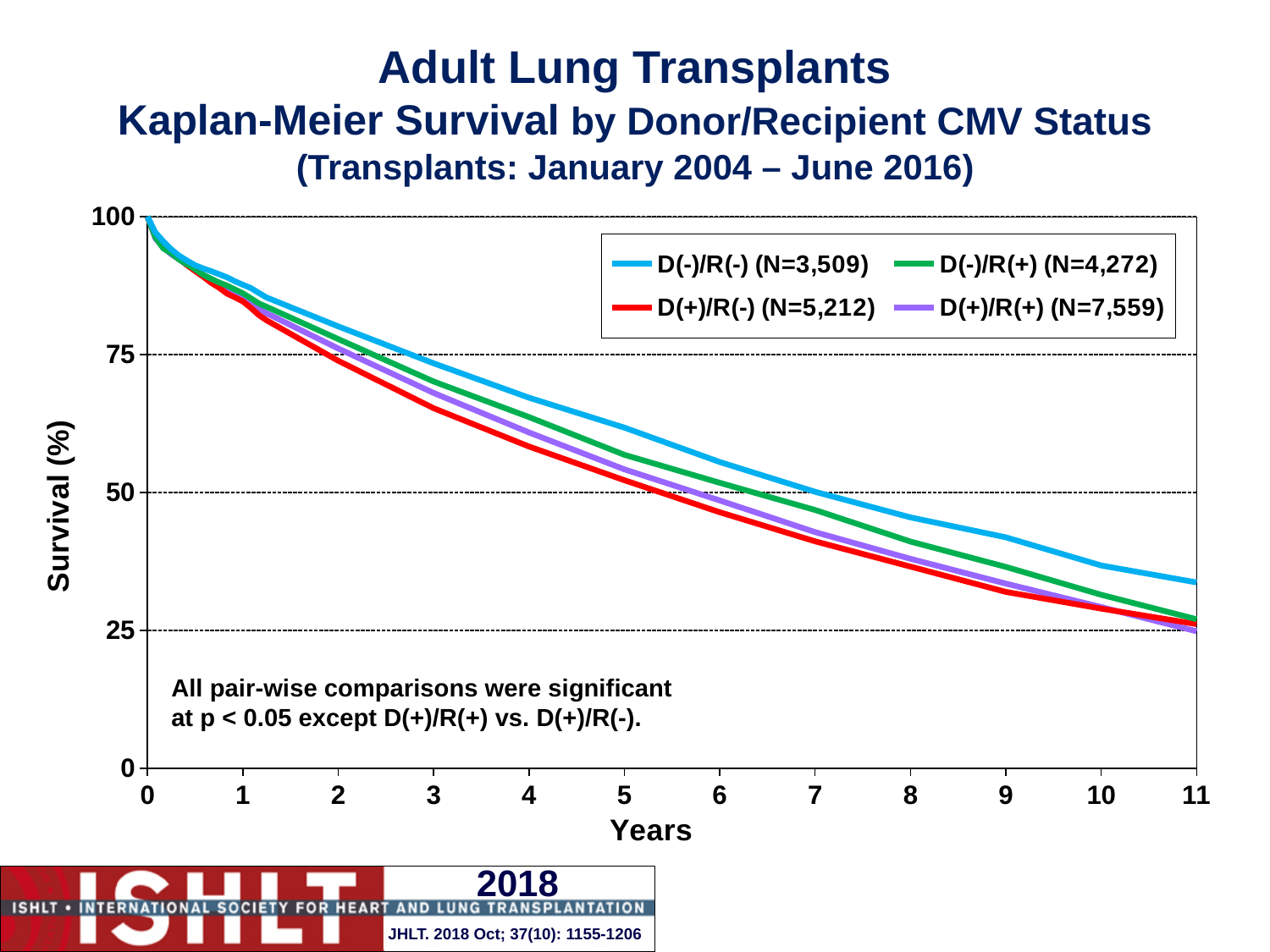
Do the survival curves rise or fall as years increase? fall Which group has the lowest survival at year 3? D(+)/R(-) What is the label of the y axis? Survival (%) What is the survival value for all groups at year 0? 100 What is the N for the D(+)/R(+) group shown in the legend? 7,559 At year 5, which group has higher survival, D(-)/R(-) or D(+)/R(-)? D(-)/R(-) What kind of chart is shown on the slide? line chart Is the survival for D(-)/R(-) at year 11 greater or less than 25? greater Is the survival for D(-)/R(+) at year 3 greater or less than 75? less Which group has the highest survival at year 11? D(-)/R(-) Is the survival for D(+)/R(-) at year 7 greater or less than 50? less How many series does the legend list? 4